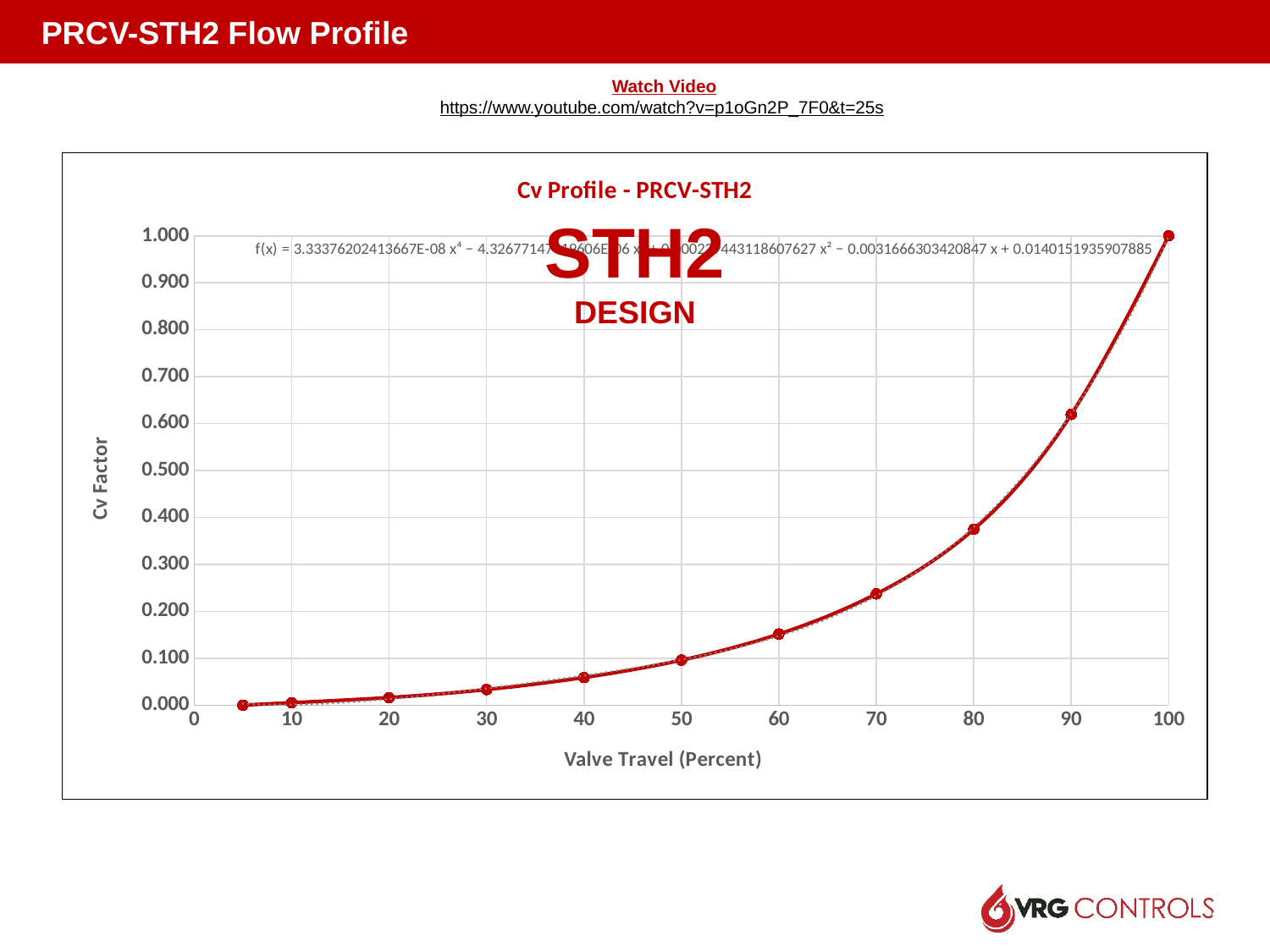
Is the Cv Factor at 60 percent valve travel greater or less than 0.100? greater Does the Cv Factor rise or fall as valve travel increases from 0 to 100 percent? rise What is the label of the x axis? Valve Travel (Percent) Is the Cv Factor at 90 percent valve travel greater or less than 0.500? greater What is the Cv Factor at 100 percent valve travel? 1.000 Which has a larger Cv Factor: 70 percent or 90 percent valve travel? 90 percent Is the Cv Factor at 50 percent valve travel greater or less than 0.200? less What type of chart is shown on the slide? line chart What is the title of the chart? Cv Profile - PRCV-STH2 At which valve travel percentage is the Cv Factor highest? 100